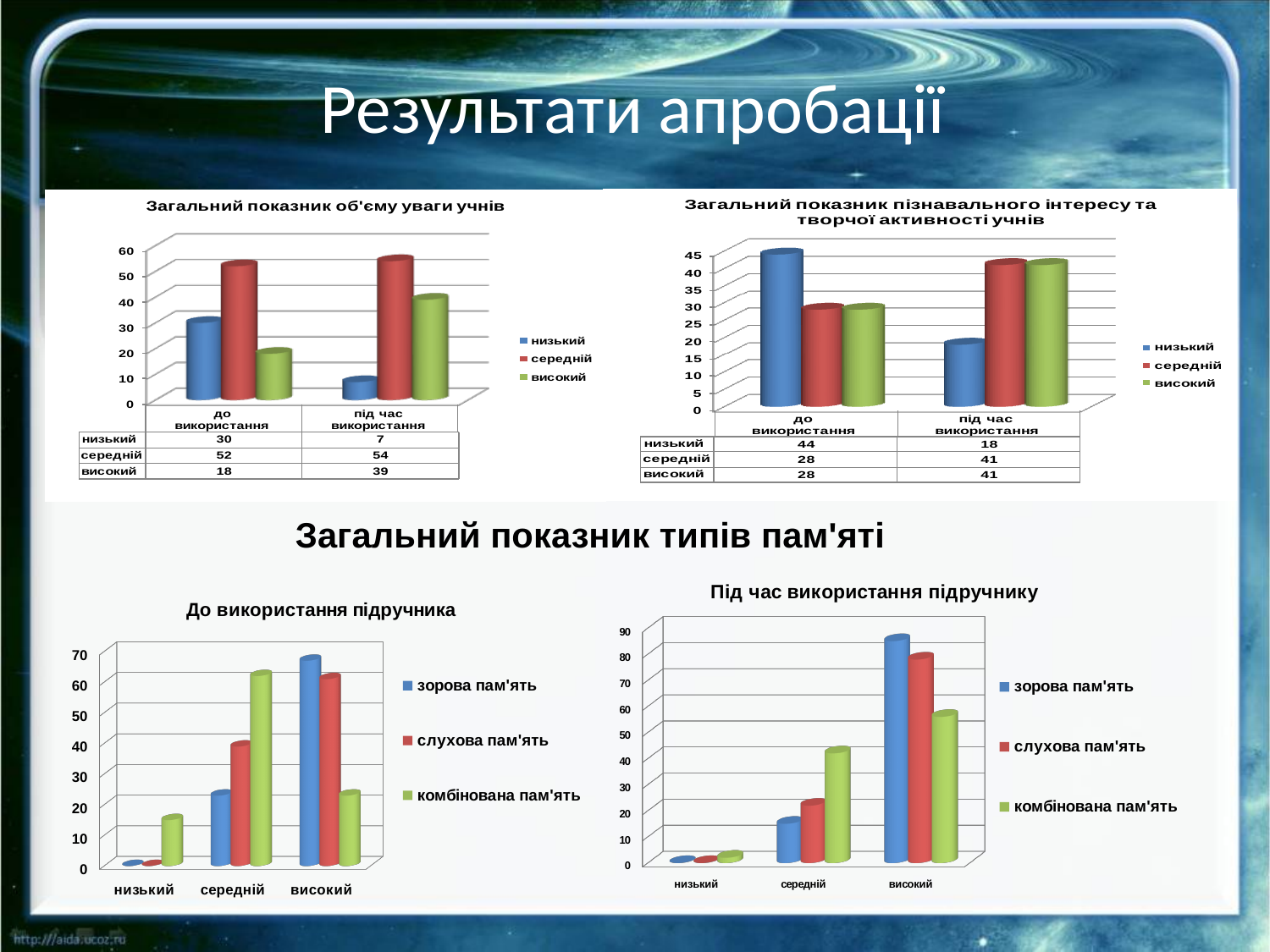
In the chart 'Загальний показник об'єму уваги учнів', what is the difference between the 'середній' values for 'під час використання' and 'до використання'? 2 In the chart 'Загальний показник пізнавального інтересу та творчої активності учнів', what is the difference between the 'низький' values for 'до використання' and 'під час використання'? 26 In the chart 'Загальний показник пізнавального інтересу та творчої активності учнів', what is the value for 'середній' in the 'під час використання' category? 41 In the chart 'Загальний показник об'єму уваги учнів', what is the value for 'високий' in the 'під час використання' category? 39 In the chart 'До використання підручника', which series has the highest value in the 'середній' category? комбінована пам'ять In the chart 'Загальний показник об'єму уваги учнів', which series has the highest value in the 'під час використання' category? середній In the chart 'Під час використання підручнику', is the value of 'зорова пам'ять' for 'високий' greater or less than 80? greater How many series does the legend of the chart 'До використання підручника' list? 3 In the chart 'Загальний показник об'єму уваги учнів', what is the value for 'низький' in the 'до використання' category? 30 What kind of chart is 'Під час використання підручнику'? bar chart In the chart 'Загальний показник пізнавального інтересу та творчої активності учнів', which series has the lowest value in the 'під час використання' category? низький In the chart 'Загальний показник пізнавального інтересу та творчої активності учнів', what is the value for 'низький' in the 'до використання' category? 44